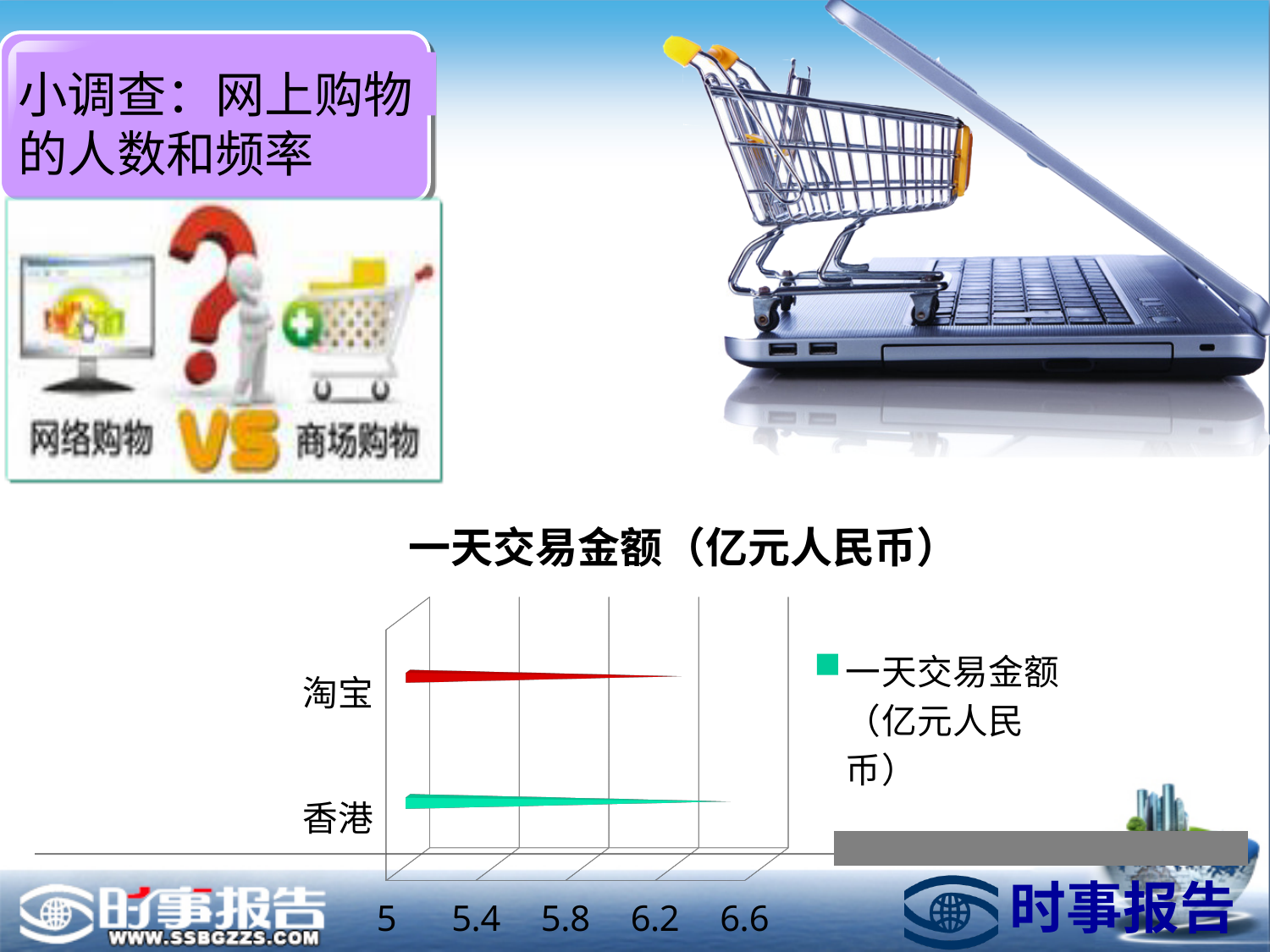
How many categories are plotted in the chart? 2 Which category has the lowest value in the chart? 淘宝 Is the value for 淘宝 greater or less than 5.8? greater Which has the larger value, 淘宝 or 香港? 香港 Which category has the highest value in the chart? 香港 How many series does the chart legend list? 1 Is the value for 香港 greater or less than 6.2? greater What kind of chart is shown under the title 一天交易金额（亿元人民币）? bar chart Is the value for 香港 greater or less than 6.6? less What colour is the bar for 淘宝? red What is the title of the chart? 一天交易金额（亿元人民币）